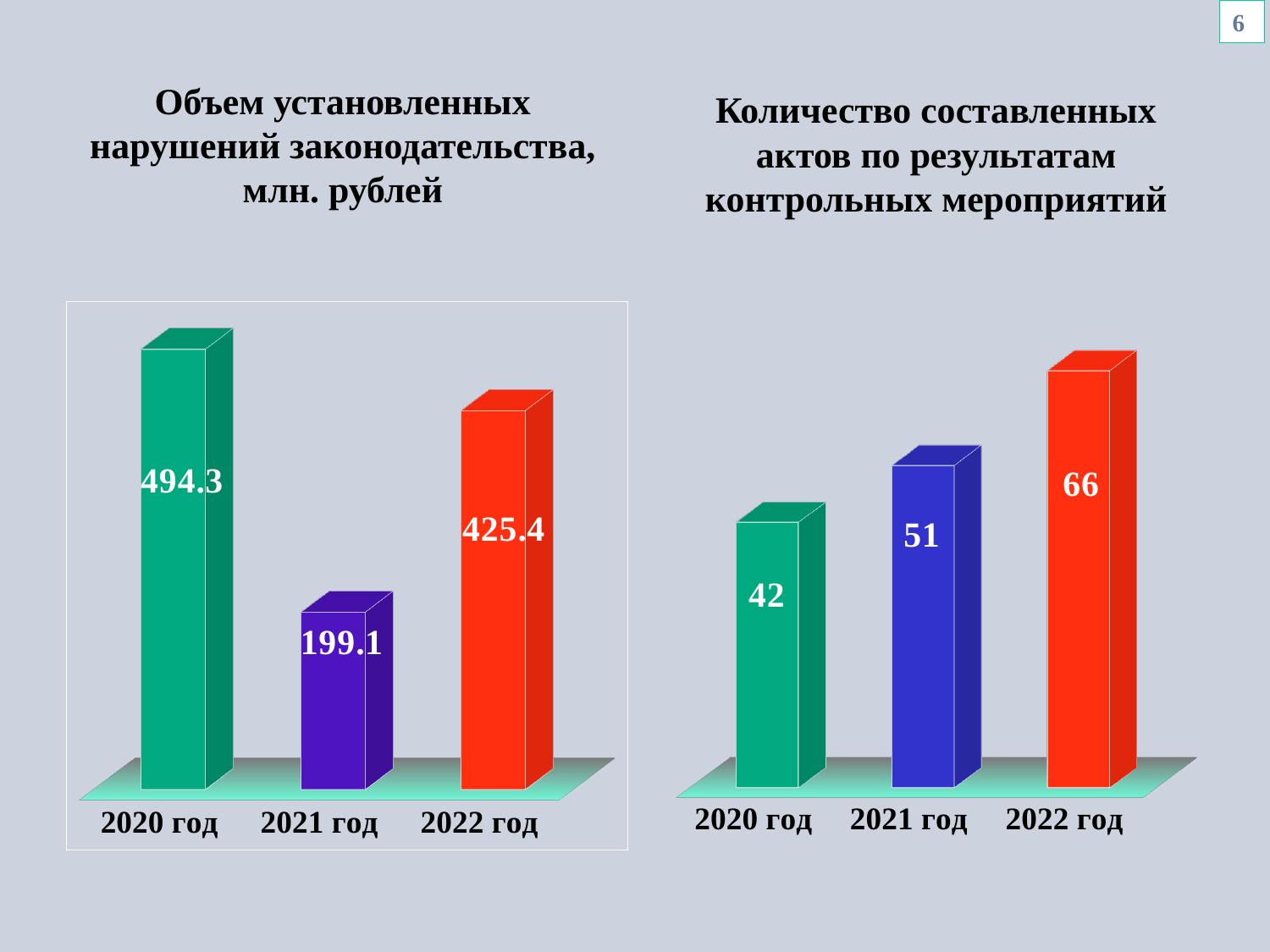
In the right chart (Количество составленных актов по результатам контрольных мероприятий), do the values rise or fall from 2020 год to 2022 год? rise In the right chart (Количество составленных актов по результатам контрольных мероприятий), what is the value for 2022 год? 66 In the left chart (Объем установленных нарушений законодательства, млн. рублей), which year has the highest value? 2020 год What type of chart is the right chart (Количество составленных актов по результатам контрольных мероприятий)? bar chart In the left chart (Объем установленных нарушений законодательства, млн. рублей), which year has the lowest value? 2021 год In the right chart (Количество составленных актов по результатам контрольных мероприятий), what is the value for 2020 год? 42 In the right chart (Количество составленных актов по результатам контрольных мероприятий), which year has the lowest value? 2020 год In the left chart (Объем установленных нарушений законодательства, млн. рублей), what is the difference between the values for 2020 год and 2022 год? 68.9 In the right chart (Количество составленных актов по результатам контрольных мероприятий), what is the difference between the values for 2022 год and 2021 год? 15 In the left chart (Объем установленных нарушений законодательства, млн. рублей), what is the value for 2021 год? 199.1 In the left chart (Объем установленных нарушений законодательства, млн. рублей), how many years are shown? 3 In the left chart (Объем установленных нарушений законодательства, млн. рублей), what is the value for 2020 год? 494.3